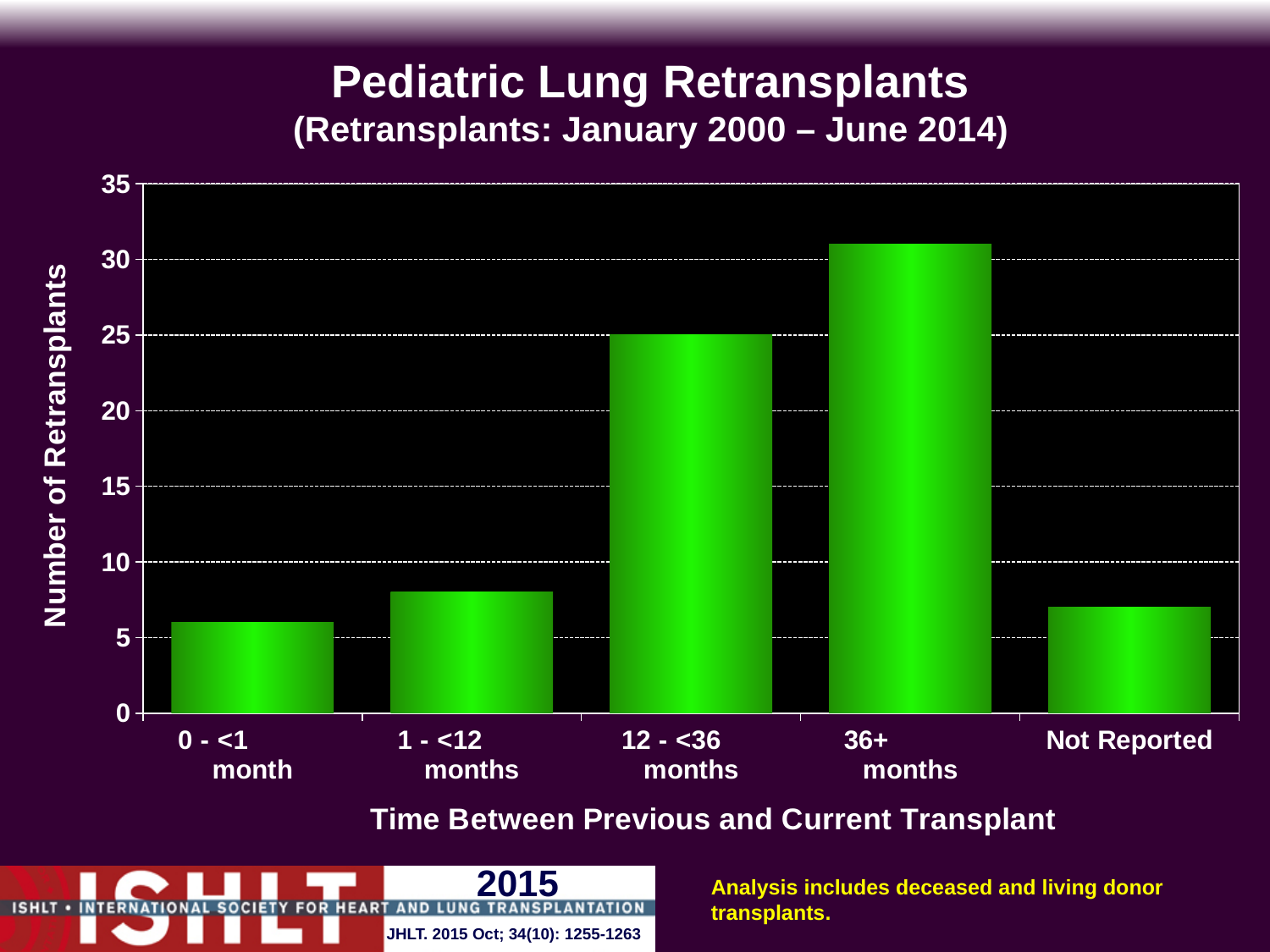
What is the title of the y axis of the chart? Number of Retransplants Is the number of retransplants for 1 - <12 months greater or less than 10? less Is the number of retransplants for 12 - <36 months greater or less than 20? greater Is the number of retransplants for 36+ months greater or less than 30? greater Which time-between-transplants category has the highest number of retransplants? 36+ months Which has more retransplants: 0 - <1 month or 12 - <36 months? 12 - <36 months What is the title of the x axis of the chart? Time Between Previous and Current Transplant How many categories are shown on the x axis of the chart? 5 What kind of chart is shown on the slide? bar chart Which has more retransplants: 12 - <36 months or 36+ months? 36+ months